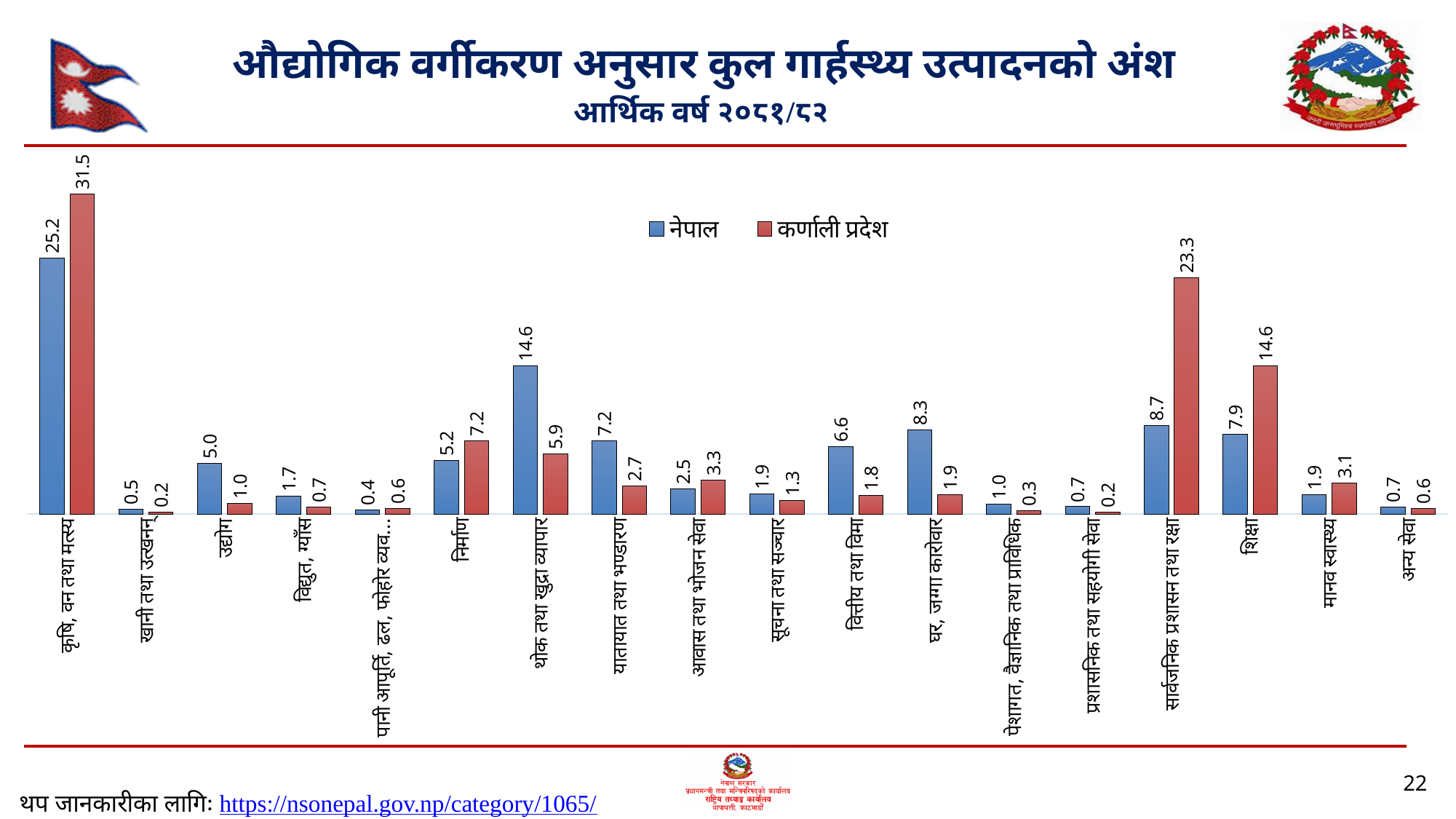
In the थोक तथा खुद्रा व्यापार category, which series has the larger value, नेपाल or कर्णाली प्रदेश? नेपाल How many categories are shown on the x axis of the chart? 18 What is the value for कर्णाली प्रदेश in the शिक्षा category? 14.6 What is the value for कर्णाली प्रदेश in the सार्वजनिक प्रशासन तथा रक्षा category? 23.3 In the निर्माण category, which series has the larger value, नेपाल or कर्णाली प्रदेश? कर्णाली प्रदेश Which category has the lowest value for नेपाल? पानी आपूर्ति, ढल, फोहोर व्यव... What is the difference between the कर्णाली प्रदेश and नेपाल values in the कृषि, वन तथा मत्स्य category? 6.3 Which colour represents the कर्णाली प्रदेश series in the chart? Red How many series does the legend list? 2 What is the value for नेपाल in the कृषि, वन तथा मत्स्य category? 25.2 Which category has the highest value for कर्णाली प्रदेश? कृषि, वन तथा मत्स्य What kind of chart is shown on the slide? Bar chart